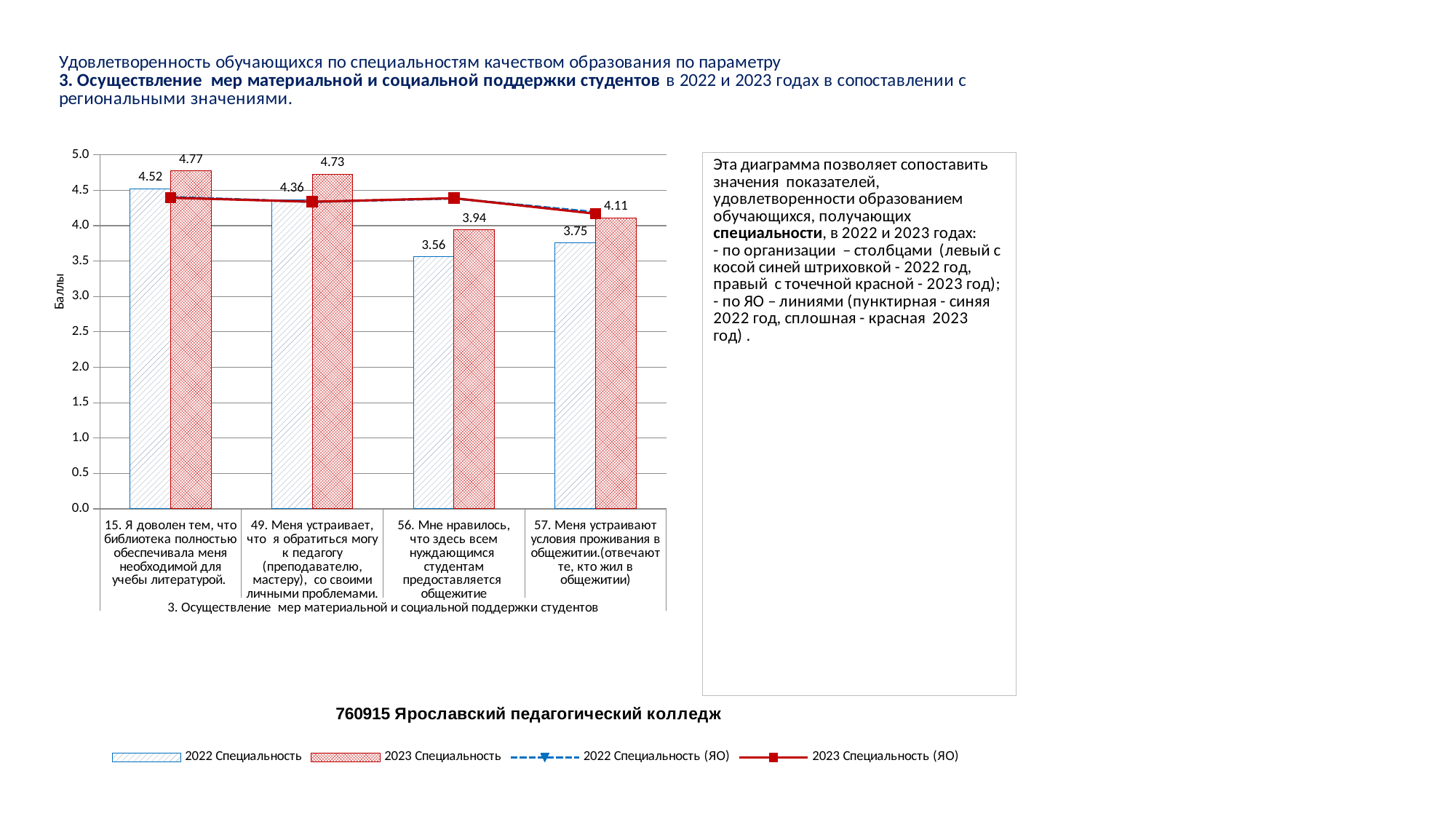
Какое значение больше: «2022 Специальность» в категории 15 или «2022 Специальность» в категории 57? Категория 15 (4.52) Какое значение у серии «2022 Специальность» для категории «15. Я доволен тем, что библиотека полностью обеспечивала меня необходимой для учебы литературой.»? 4.52 На сколько значение «2023 Специальность» больше значения «2022 Специальность» в категории «49. Меня устраивает, что я обратиться могу к педагогу...»? 0.37 В какой категории значение серии «2022 Специальность» наибольшее? 15. Я доволен тем, что библиотека полностью обеспечивала меня необходимой для учебы литературой. В какой категории значение серии «2023 Специальность» наименьшее? 56. Мне нравилось, что здесь всем нуждающимся студентам предоставляется общежитие Сколько категорий показано на оси X диаграммы? 4 Значение линии «2023 Специальность (ЯО)» в категории 56 больше или меньше 4.0? больше Сколько серий перечислено в легенде диаграммы? 4 Как подписана вертикальная ось диаграммы? Баллы Какое значение у серии «2023 Специальность» для категории «56. Мне нравилось, что здесь всем нуждающимся студентам предоставляется общежитие»? 3.94 Какое значение у серии «2023 Специальность» для категории «57. Меня устраивают условия проживания в общежитии»? 4.11 Какого типа эта диаграмма? Столбчатая (bar chart) с линиями